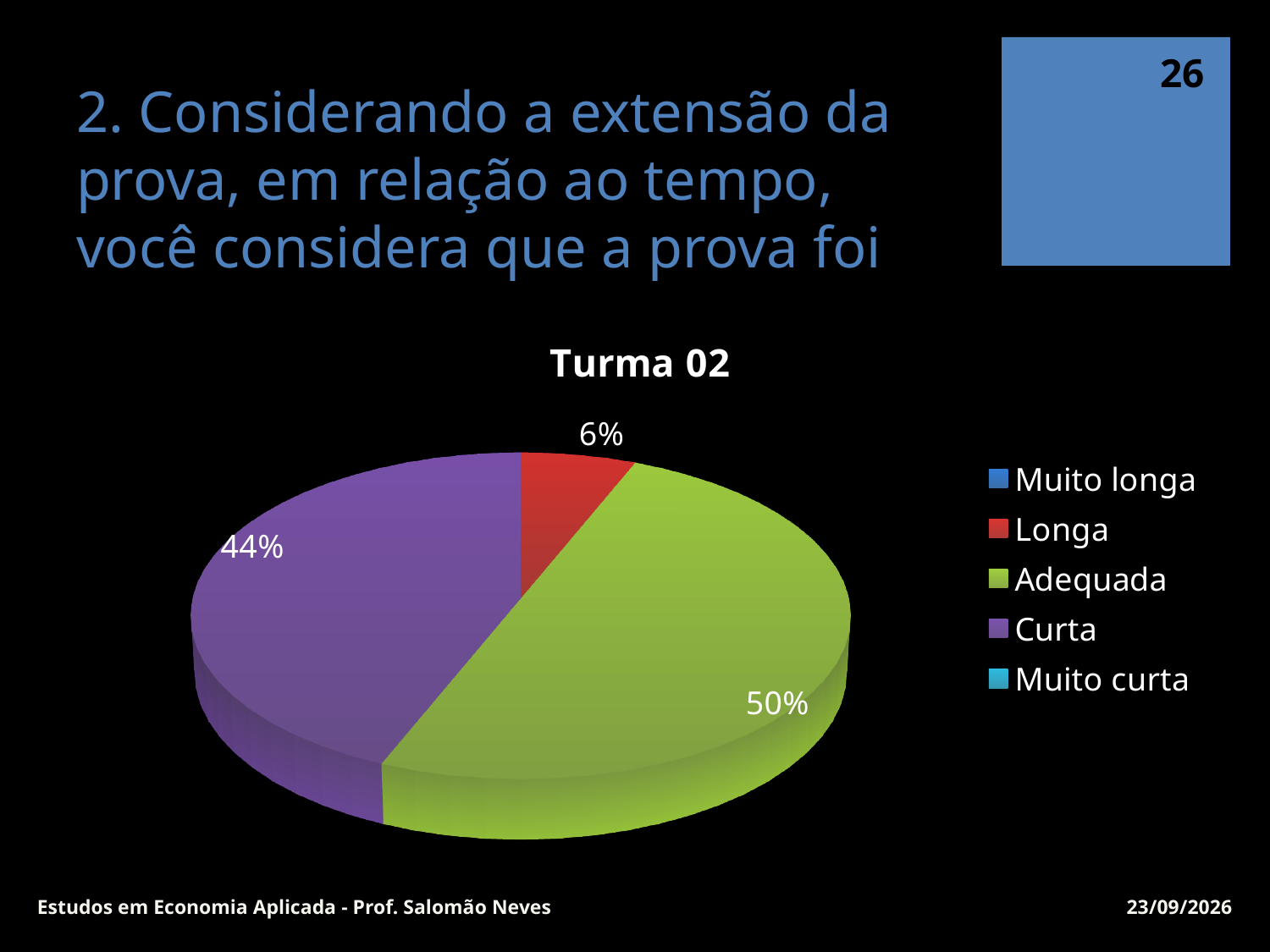
Which category has the largest slice of the pie? Adequada Among the slices with labels shown, which category has the smallest slice? Longa Which slice is larger, Curta or Longa? Curta What kind of chart is shown on the slide? pie chart What percentage of the pie is labelled for Longa? 6% How many entries does the chart's legend list? 5 What is the difference in percentage points between the Adequada slice and the Curta slice? 6 What percentage of the pie is labelled for Adequada? 50% How many slices with percentage labels are visible in the pie? 3 What is the title of the chart? Turma 02 What percentage of the pie is labelled for Curta? 44% What colour is the slice for Curta? purple